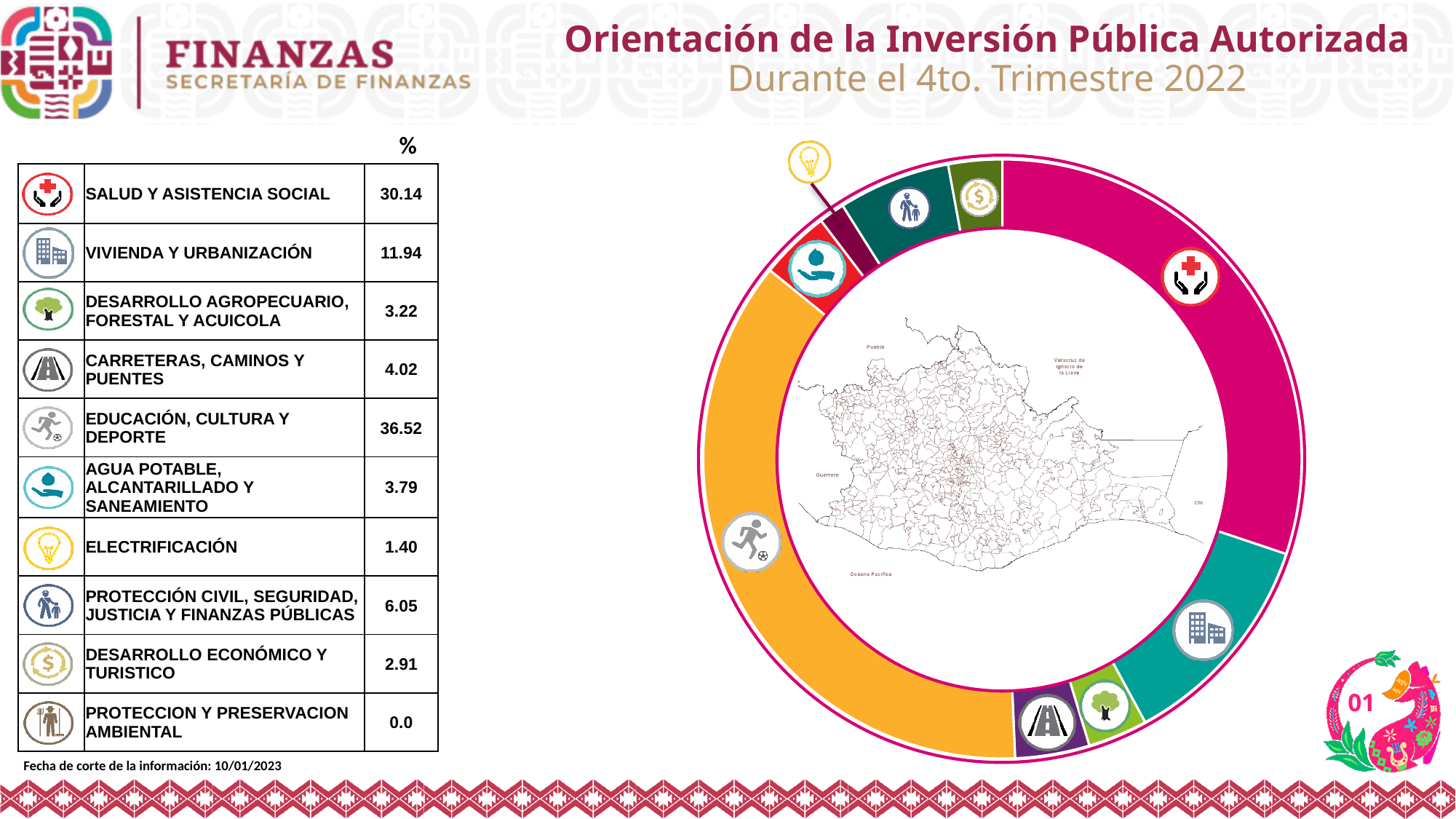
What percentage is shown for EDUCACIÓN, CULTURA Y DEPORTE? 36.52 Which is larger, the percentage for CARRETERAS, CAMINOS Y PUENTES or for DESARROLLO AGROPECUARIO, FORESTAL Y ACUICOLA? CARRETERAS, CAMINOS Y PUENTES Which category has the highest percentage? EDUCACIÓN, CULTURA Y DEPORTE Which category has the lowest percentage? PROTECCION Y PRESERVACION AMBIENTAL Which is larger, the percentage for VIVIENDA Y URBANIZACIÓN or for PROTECCIÓN CIVIL, SEGURIDAD, JUSTICIA Y FINANZAS PÚBLICAS? VIVIENDA Y URBANIZACIÓN What percentage is shown for ELECTRIFICACIÓN? 1.40 What is the difference in percentage points between EDUCACIÓN, CULTURA Y DEPORTE and SALUD Y ASISTENCIA SOCIAL? 6.38 What percentage is shown for SALUD Y ASISTENCIA SOCIAL? 30.14 How many categories are listed in the table? 10 What colour is the largest segment of the donut chart? orange What kind of chart is shown on the right of the slide? donut chart What percentage is shown for PROTECCIÓN CIVIL, SEGURIDAD, JUSTICIA Y FINANZAS PÚBLICAS? 6.05